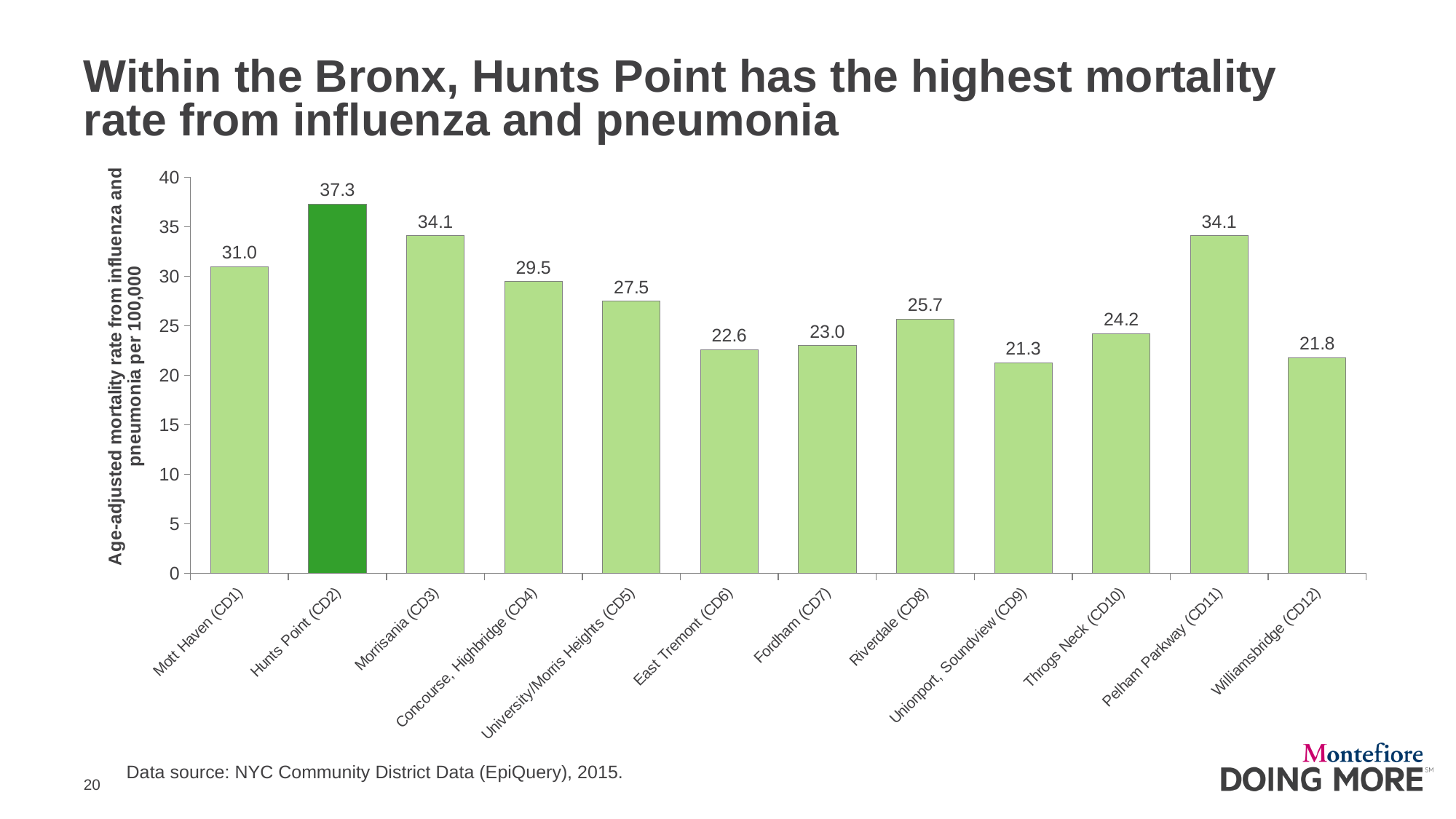
Which bar is shown in a darker green than the others? Hunts Point (CD2) Is the value for University/Morris Heights (CD5) greater or less than 25? greater Which community district has the lowest mortality rate from influenza and pneumonia? Unionport, Soundview (CD9) Which has a higher value, Throgs Neck (CD10) or Fordham (CD7)? Throgs Neck (CD10) What is the difference between the values for Concourse, Highbridge (CD4) and East Tremont (CD6)? 6.9 What is the difference between the values for Hunts Point (CD2) and Mott Haven (CD1)? 6.3 What is the age-adjusted mortality rate from influenza and pneumonia for Hunts Point (CD2)? 37.3 Which community district has the highest mortality rate from influenza and pneumonia? Hunts Point (CD2) How many community districts are shown on the chart? 12 What is the value shown for Williamsbridge (CD12)? 21.8 What is the value shown for Riverdale (CD8)? 25.7 What kind of chart is shown on the slide? Bar chart